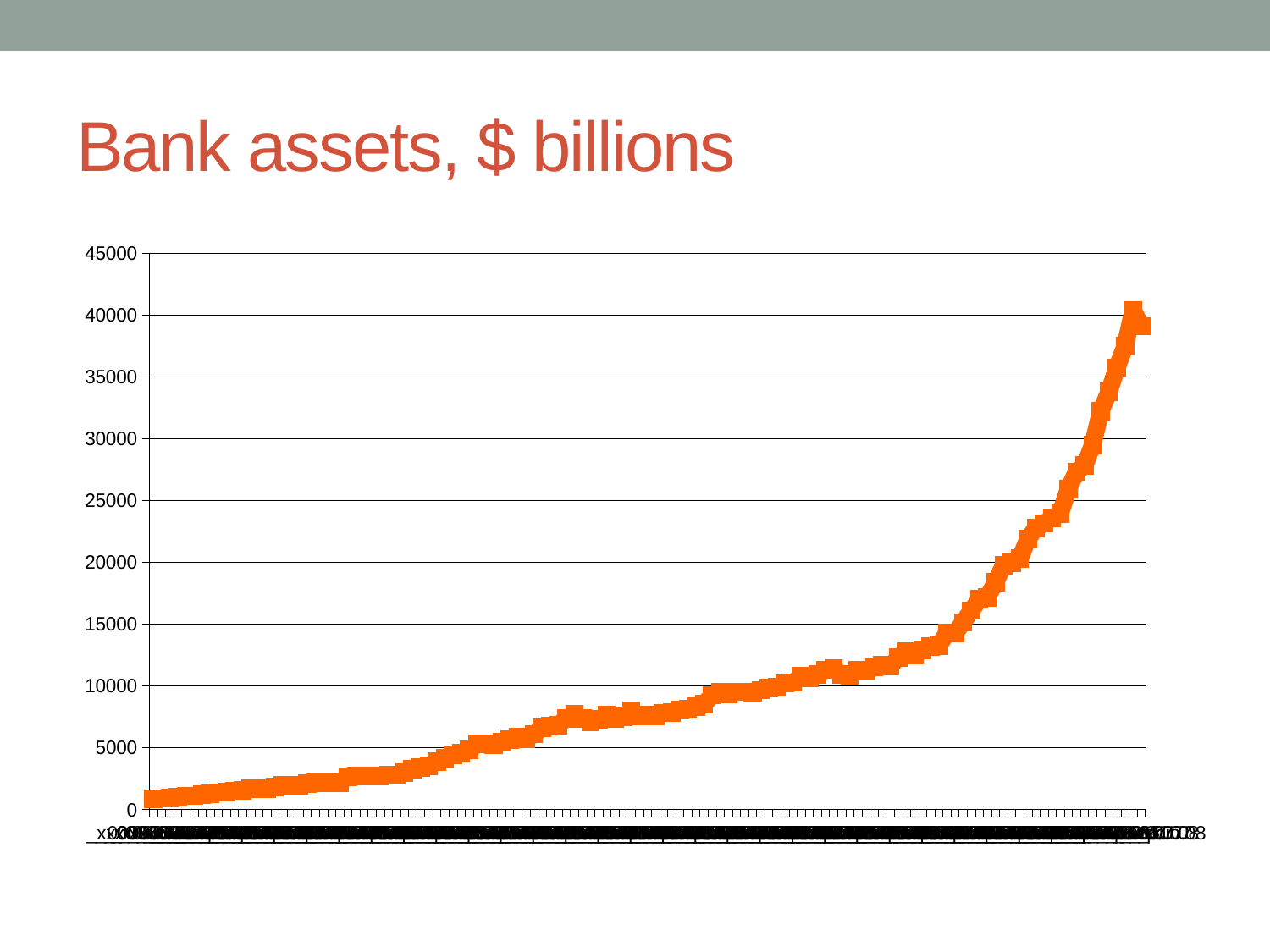
What kind of chart is shown on the slide? line chart Is the value at the left-hand start of the line greater or less than 5000? less Is the value at the right-hand end of the line greater or less than 30000? greater What is the title of the chart? Bank assets, $ billions Do the values generally rise or fall from left to right along the x axis? rise What colour is the plotted line? orange Is the highest value reached by the line greater or less than 35000? greater What is the highest tick value shown on the y axis? 45000 Is the peak of the line reached near the left end or the right end of the x axis? right end Is the lowest point of the line at the left end or the right end of the x axis? left end